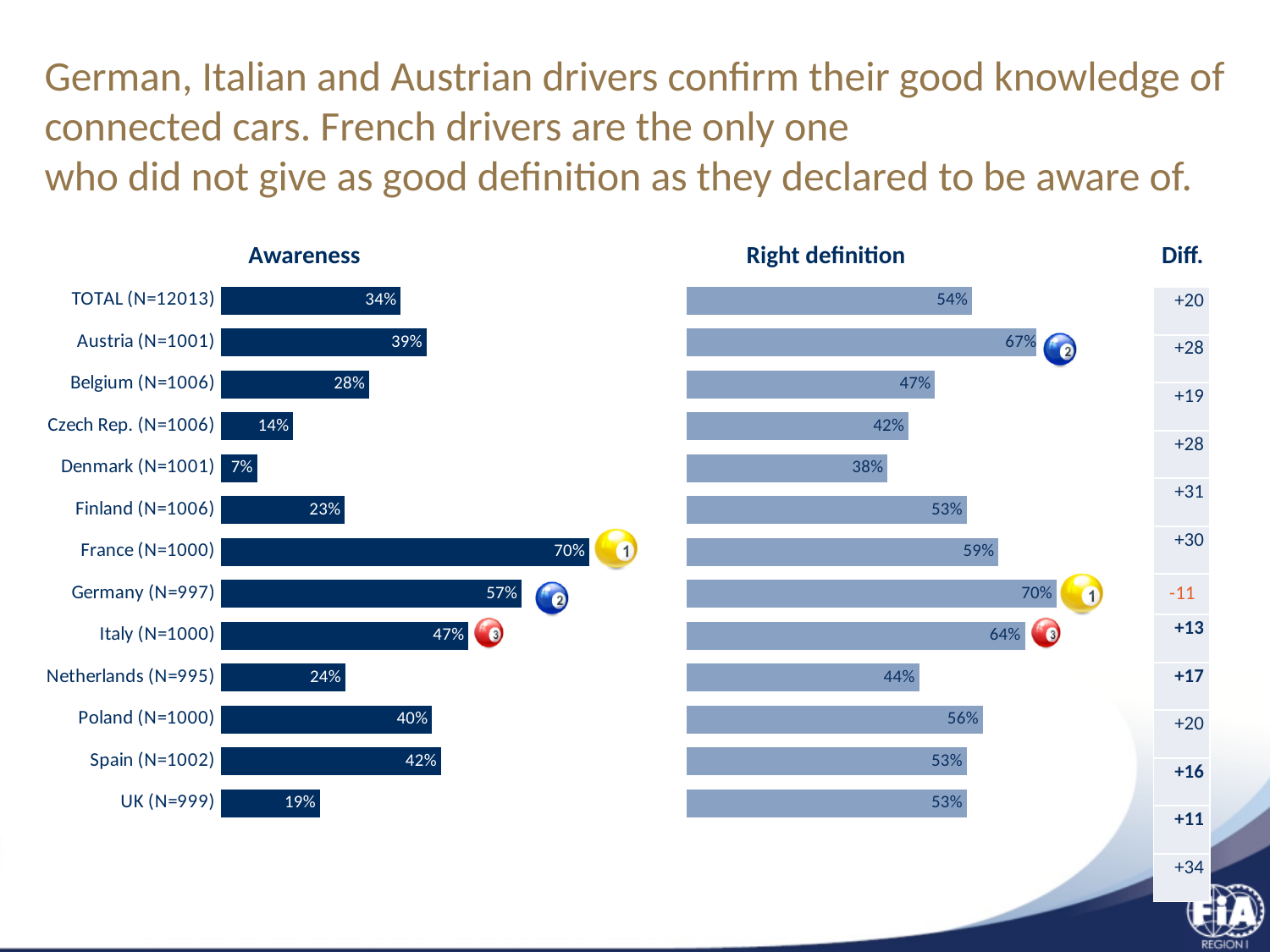
In the Awareness chart, which is larger, the value for Poland (N=1000) or Spain (N=1002)? Spain (N=1002) In the Right definition chart, which country has the lowest value? Denmark (N=1001) How many countries or categories are shown in the Awareness chart? 13 In the Right definition chart, what is the value for Germany (N=997)? 70% What type of chart is the Right definition chart? Bar chart In the Awareness chart, what is the difference between the values for Germany (N=997) and Italy (N=1000)? 10% In the Right definition chart, what is the difference between the values for Austria (N=1001) and Belgium (N=1006)? 20% In the Right definition chart, what is the value for TOTAL (N=12013)? 54% In the Awareness chart, what is the value for France (N=1000)? 70% In the Right definition chart, which category has the highest value? Germany (N=997) In the Awareness chart, which country has the lowest value? Denmark (N=1001) In the Awareness chart, which category has the highest value? France (N=1000)